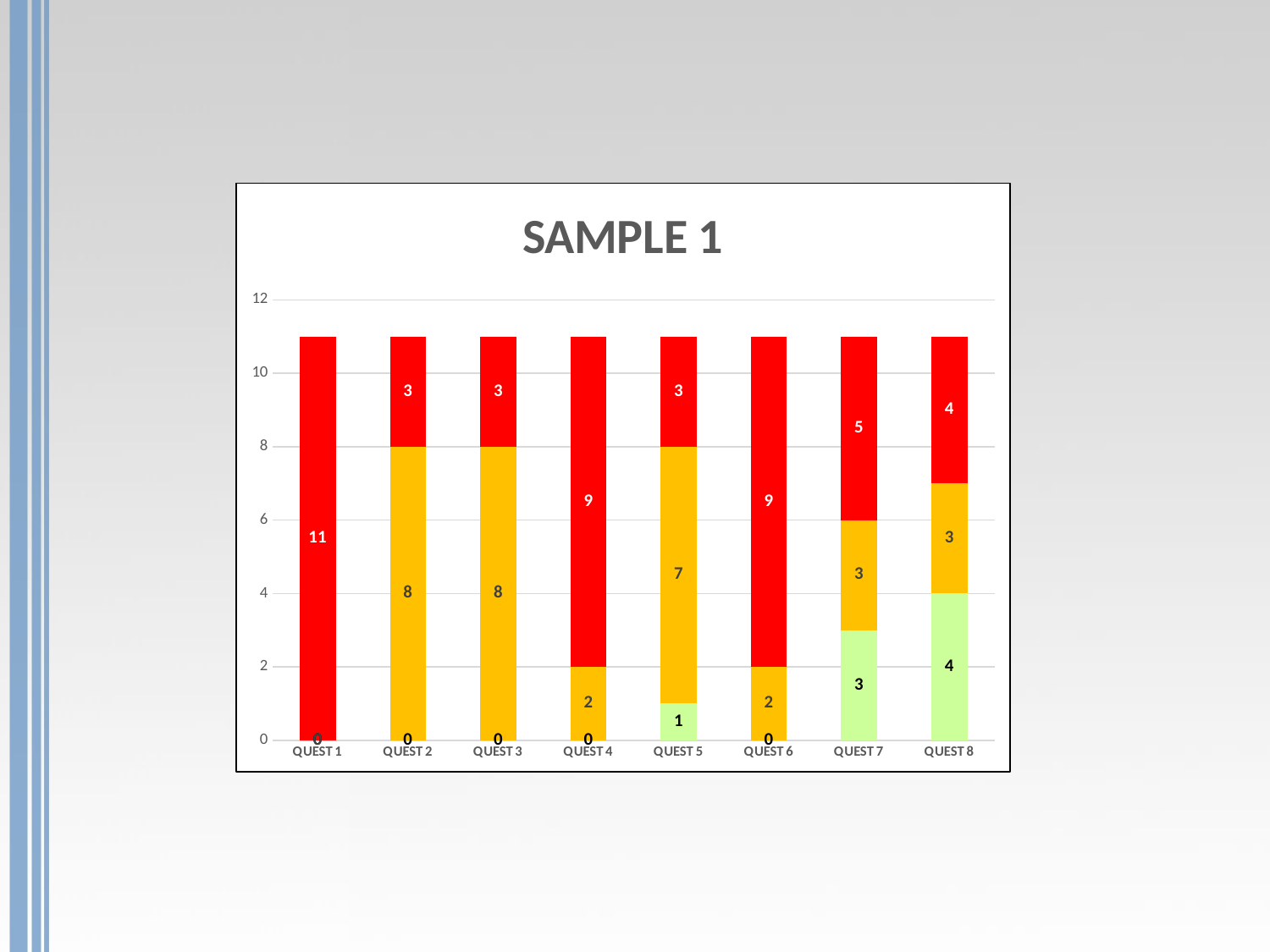
What is the value of the green segment for QUEST 8? 4 Which category has the largest red segment? QUEST 1 What kind of chart is shown on the slide? Stacked bar chart What is the value of the red segment for QUEST 6? 9 What is the value of the red segment for QUEST 1? 11 What is the total of the stacked bar for QUEST 7? 11 Which category has the largest green segment? QUEST 8 Which has the larger red segment, QUEST 7 or QUEST 8? QUEST 7 How many categories (QUEST bars) are shown on the x axis? 8 What is the value of the orange segment for QUEST 5? 7 What is the difference between the orange segment for QUEST 2 and the orange segment for QUEST 4? 6 What is the title of the chart? SAMPLE 1